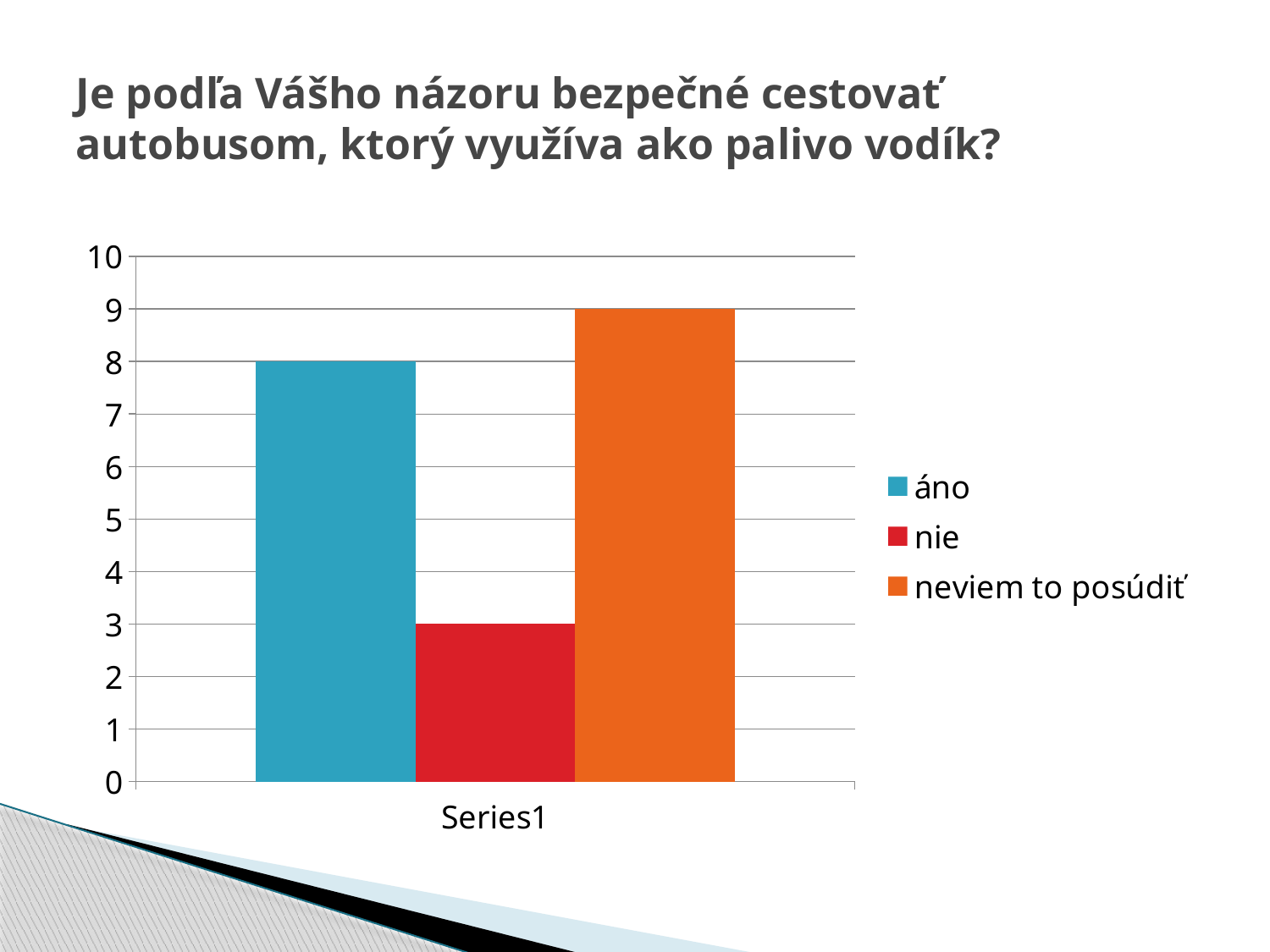
Which is larger, the value for "áno" or the value for "nie"? áno What is the value for "neviem to posúdiť"? 9 What kind of chart is shown on the slide? bar chart Which response has the highest value? neviem to posúdiť What is the value for "áno"? 8 How many series does the legend list? 3 Which response has the lowest value? nie What colour is the bar for "nie"? red Is the value for "nie" greater or less than 5? less What is the difference between the values for "áno" and "nie"? 5 What is the difference between the values for "neviem to posúdiť" and "áno"? 1 What is the value for "nie"? 3